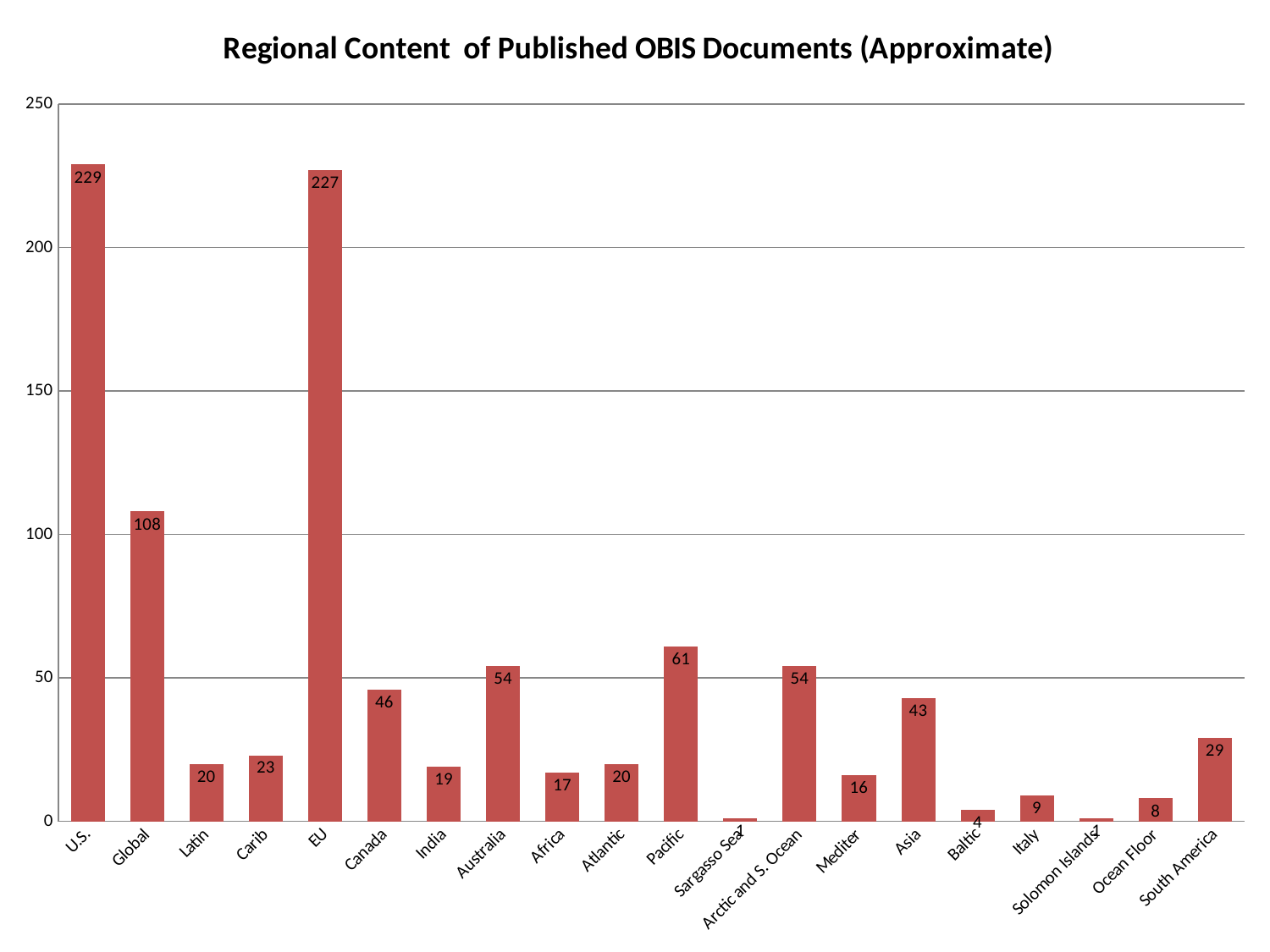
What is the value for South America? 29 What is the value for Global? 108 What is the difference between the values for U.S. and EU? 2 What is the value for Pacific? 61 What is the difference between the values for Global and Canada? 62 What kind of chart is shown on the slide? Bar chart Which category has the highest value? U.S. How many categories are shown on the x axis? 20 What is the value for U.S.? 229 Which is larger, the value for Australia or the value for Canada? Australia What is the title of the chart? Regional Content of Published OBIS Documents (Approximate) Is the value for Global greater or less than 100? greater